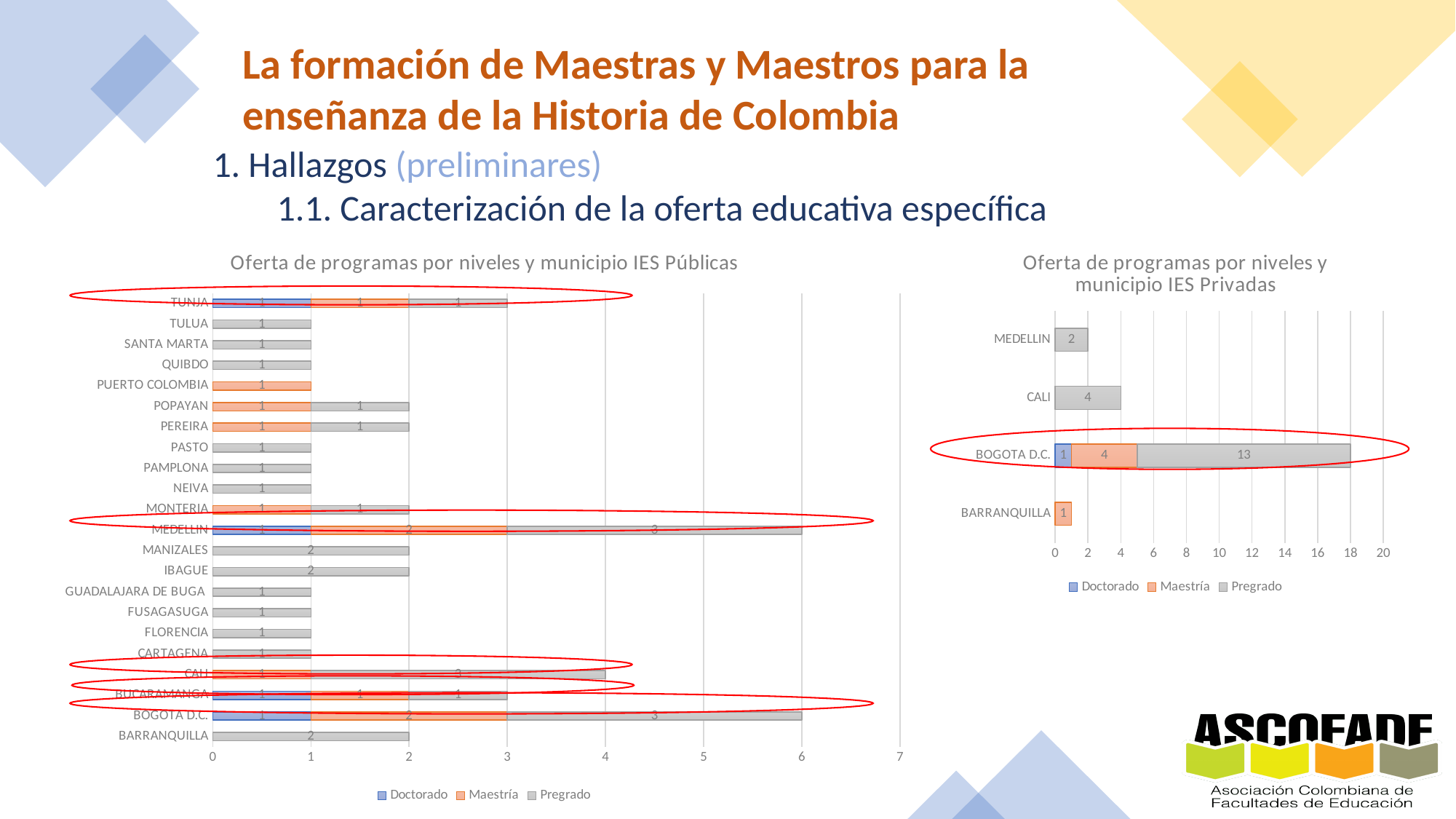
In the chart 'Oferta de programas por niveles y municipio IES Privadas', what is the Pregrado value for BOGOTA D.C.? 13 In the chart 'Oferta de programas por niveles y municipio IES Públicas', what is the Pregrado value for MEDELLIN? 3 How many series does the legend of the chart 'Oferta de programas por niveles y municipio IES Públicas' list? 3 In the chart 'Oferta de programas por niveles y municipio IES Públicas', what is the Maestría value for CALI? 1 In the chart 'Oferta de programas por niveles y municipio IES Privadas', which municipality has the lowest total? BARRANQUILLA In the chart 'Oferta de programas por niveles y municipio IES Privadas', what is the value for CALI? 4 In the chart 'Oferta de programas por niveles y municipio IES Públicas', how many municipalities are listed? 22 What type of chart is 'Oferta de programas por niveles y municipio IES Privadas'? Stacked bar chart In the chart 'Oferta de programas por niveles y municipio IES Públicas', what is the total of the stacked bar for BOGOTA D.C.? 6 In the chart 'Oferta de programas por niveles y municipio IES Públicas', which is larger, the total for CALI or the total for BUCARAMANGA? CALI In the chart 'Oferta de programas por niveles y municipio IES Privadas', what is the total of the stacked bar for BOGOTA D.C.? 18 In the chart 'Oferta de programas por niveles y municipio IES Privadas', how many municipalities are shown? 4